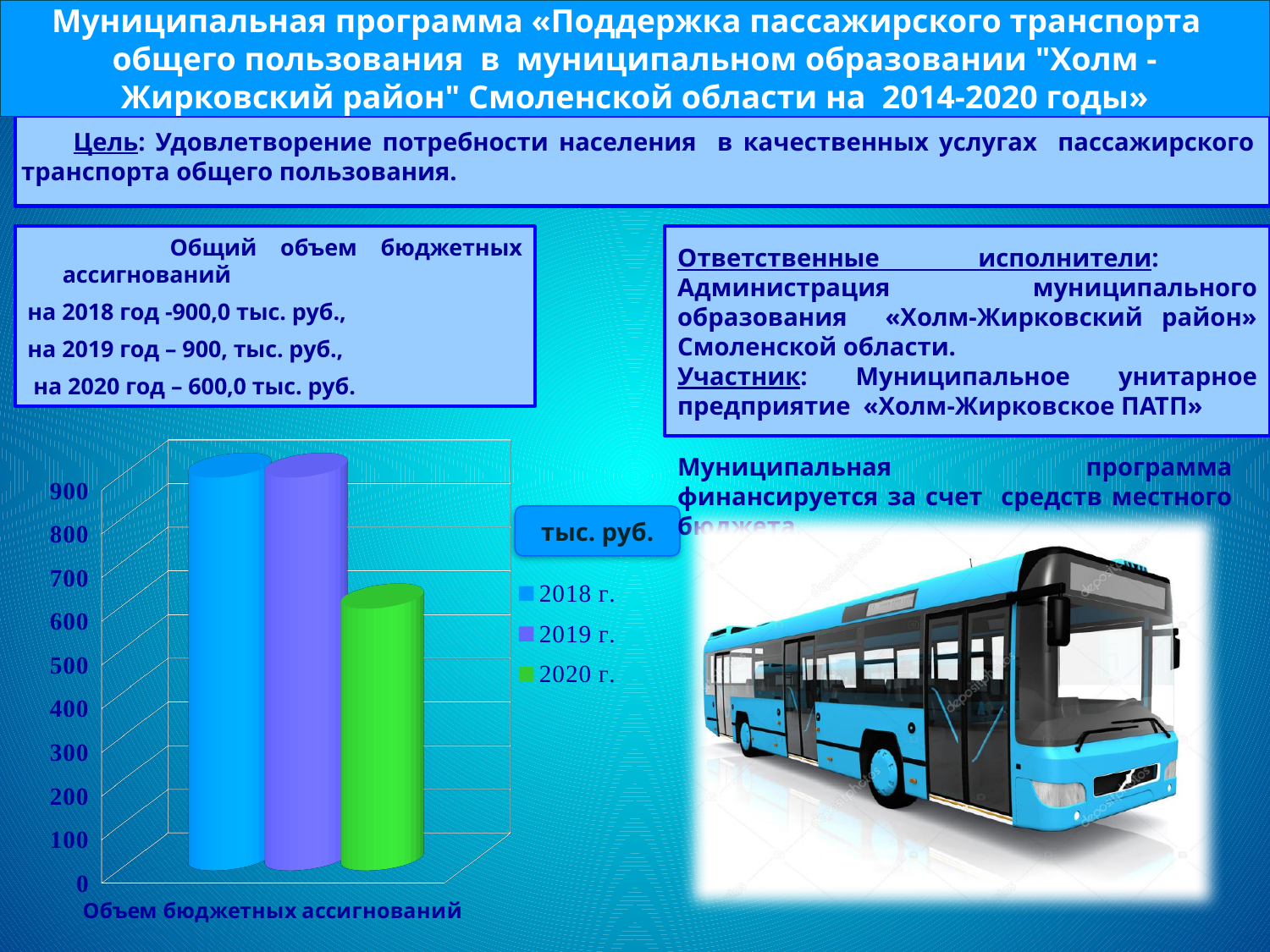
Is the value for 2019 г. greater or less than 700? greater Which series are listed in the chart legend? 2018 г., 2019 г., 2020 г. What is the category label on the x axis of the chart? Объем бюджетных ассигнований Which year has the lowest bar in the chart? 2020 г. Is the value for 2020 г. greater or less than 800? less How many categories are shown on the x axis of the chart? 1 Is the value for 2020 г. greater or less than 500? greater Which is larger in the chart, the bar for 2018 г. or the bar for 2020 г.? 2018 г. What kind of chart is shown on the slide? bar chart How many series does the chart legend list? 3 Which is larger in the chart, the bar for 2019 г. or the bar for 2020 г.? 2019 г.